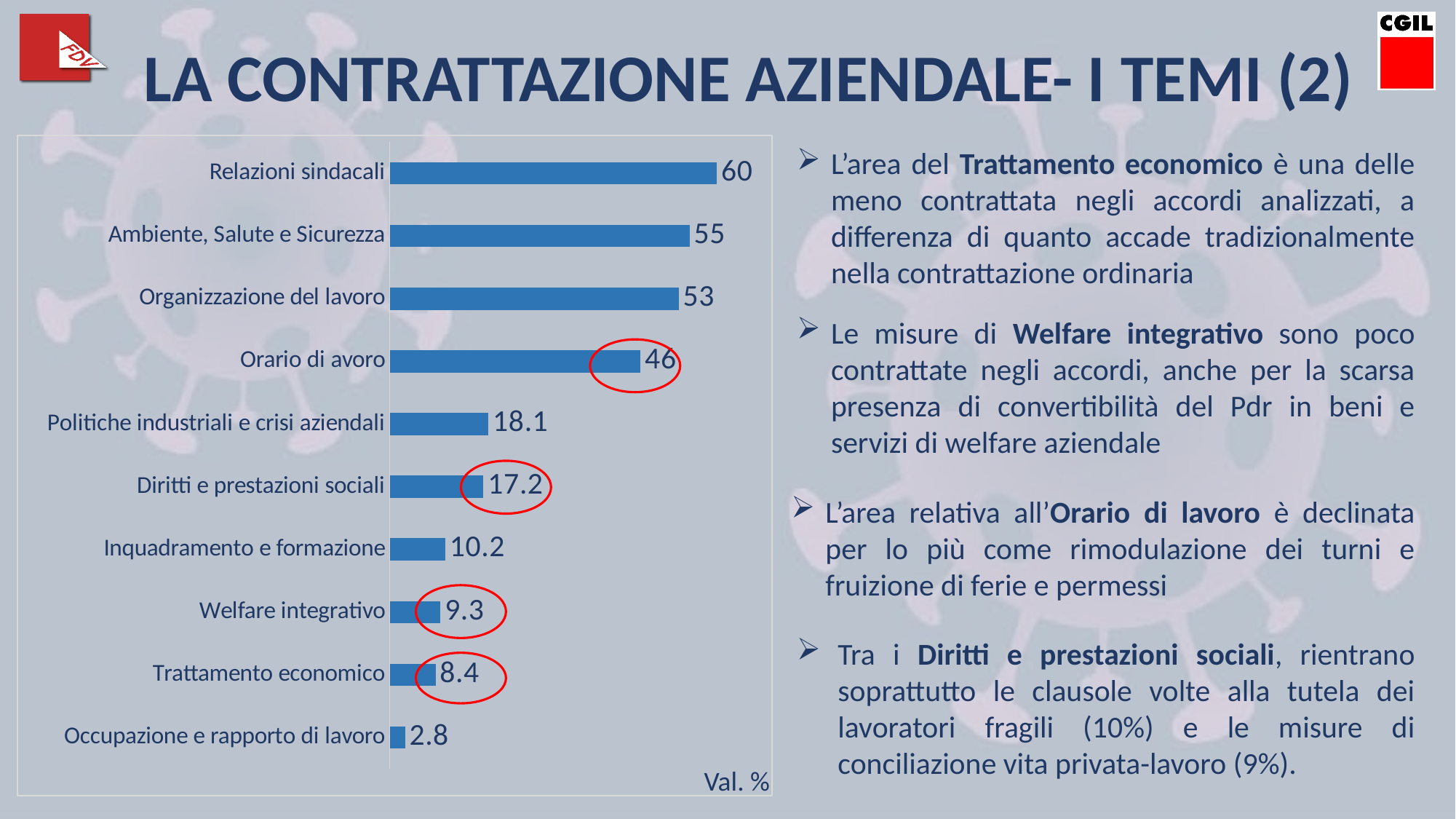
What unit label is shown at the bottom right of the chart? Val. % What is the value for Orario di avoro? 46 What is the value for Welfare integrativo? 9.3 What is the value for Relazioni sindacali? 60 How many categories are shown in the chart? 10 Which category has the lowest value? Occupazione e rapporto di lavoro What is the value for Trattamento economico? 8.4 Which category has the highest value? Relazioni sindacali What is the difference between the values for Politiche industriali e crisi aziendali and Diritti e prestazioni sociali? 0.9 Which is larger, the value for Inquadramento e formazione or the value for Welfare integrativo? Inquadramento e formazione What is the difference between the values for Ambiente, Salute e Sicurezza and Organizzazione del lavoro? 2 What kind of chart is shown on the slide? Bar chart